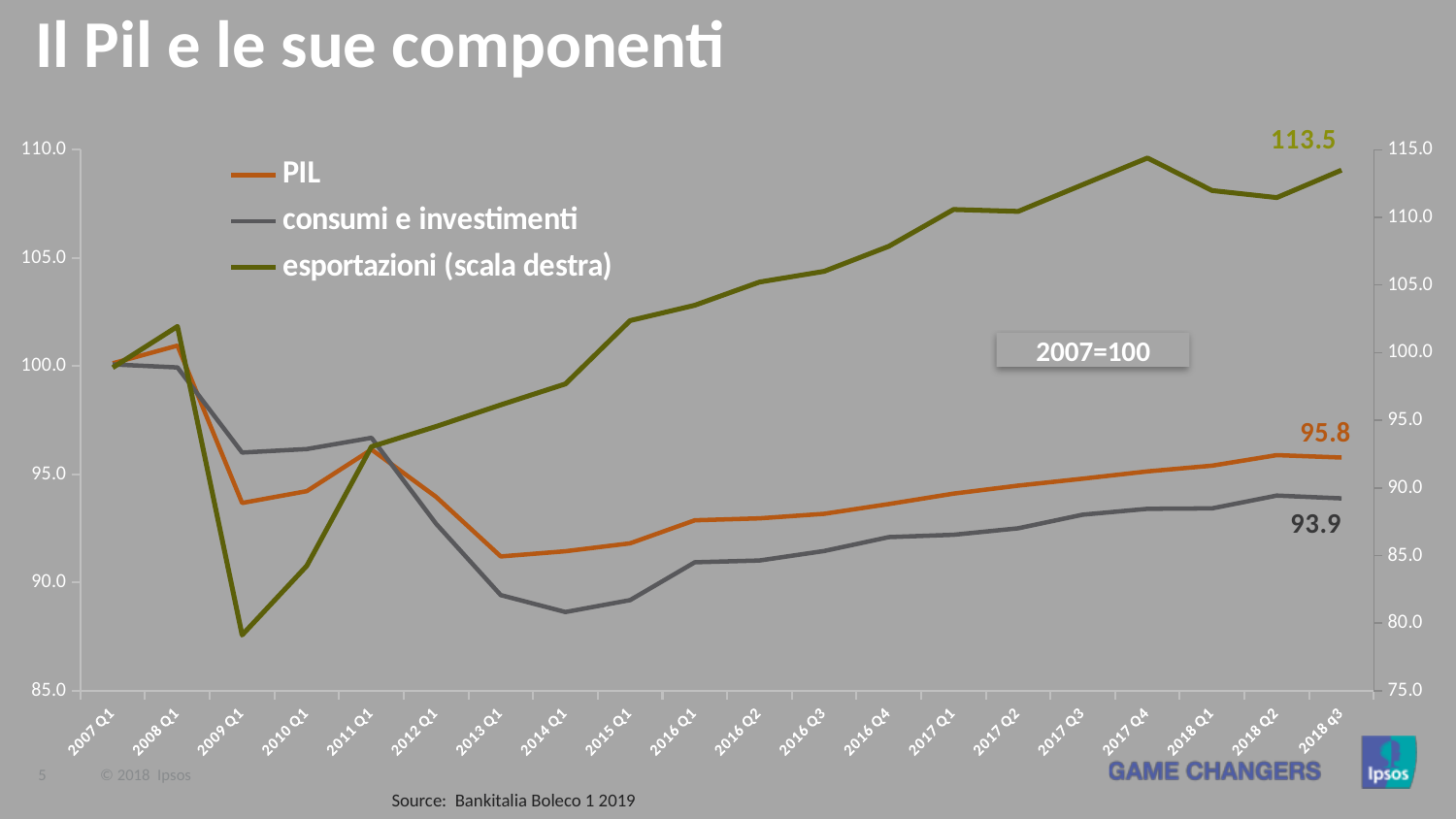
How many time points are shown on the x axis? 20 What is the value of esportazioni (scala destra) at 2018 q3? 113.5 Is the value for PIL at 2013 Q1 greater or less than 95.0? less At 2018 q3, which is larger: PIL or consumi e investimenti? PIL What kind of chart is shown on the slide? line chart At which time point does consumi e investimenti reach its lowest value? 2014 Q1 Does the esportazioni (scala destra) line rise or fall from 2012 Q1 to 2018 q3? rise What is the value of consumi e investimenti at 2018 q3? 93.9 What is the value of PIL at 2018 q3? 95.8 How many series does the legend list? 3 What is the difference between PIL and consumi e investimenti at 2018 q3? 1.9 Is the value for esportazioni (scala destra) at 2009 Q1 greater or less than 85.0 on the right axis? less